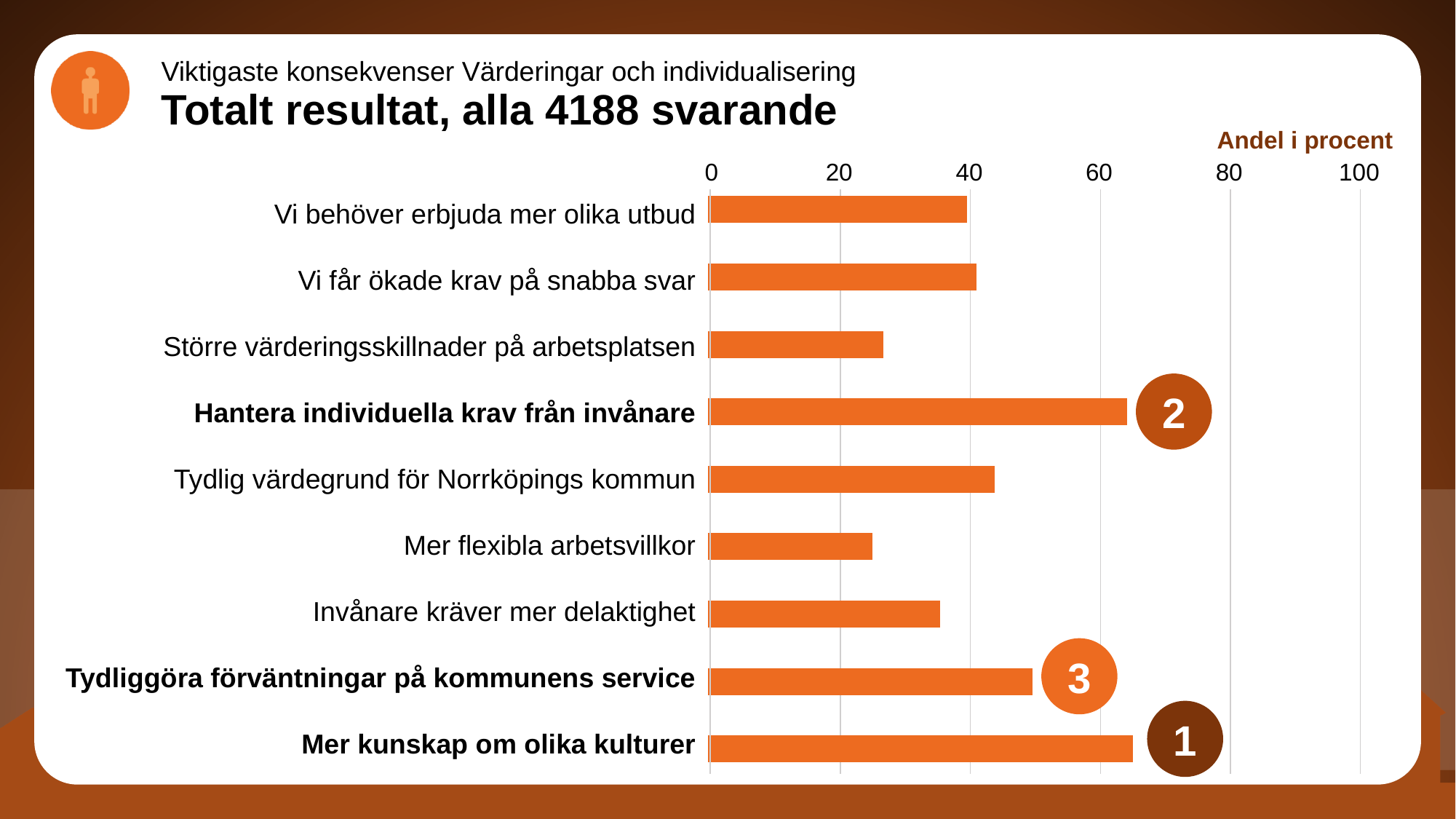
Which category is marked with the badge "1" on the chart? Mer kunskap om olika kulturer Is the value for "Större värderingsskillnader på arbetsplatsen" greater or less than 20? greater Is the value for "Mer kunskap om olika kulturer" greater or less than 60? greater Which has the larger value: "Tydliggöra förväntningar på kommunens service" or "Invånare kräver mer delaktighet"? Tydliggöra förväntningar på kommunens service Is the value for "Tydliggöra förväntningar på kommunens service" greater or less than 40? greater How many categories are plotted in the chart? 9 What kind of chart is shown on the slide? bar chart Which has the larger value: "Hantera individuella krav från invånare" or "Mer flexibla arbetsvillkor"? Hantera individuella krav från invånare What label is shown above the horizontal axis of the chart? Andel i procent